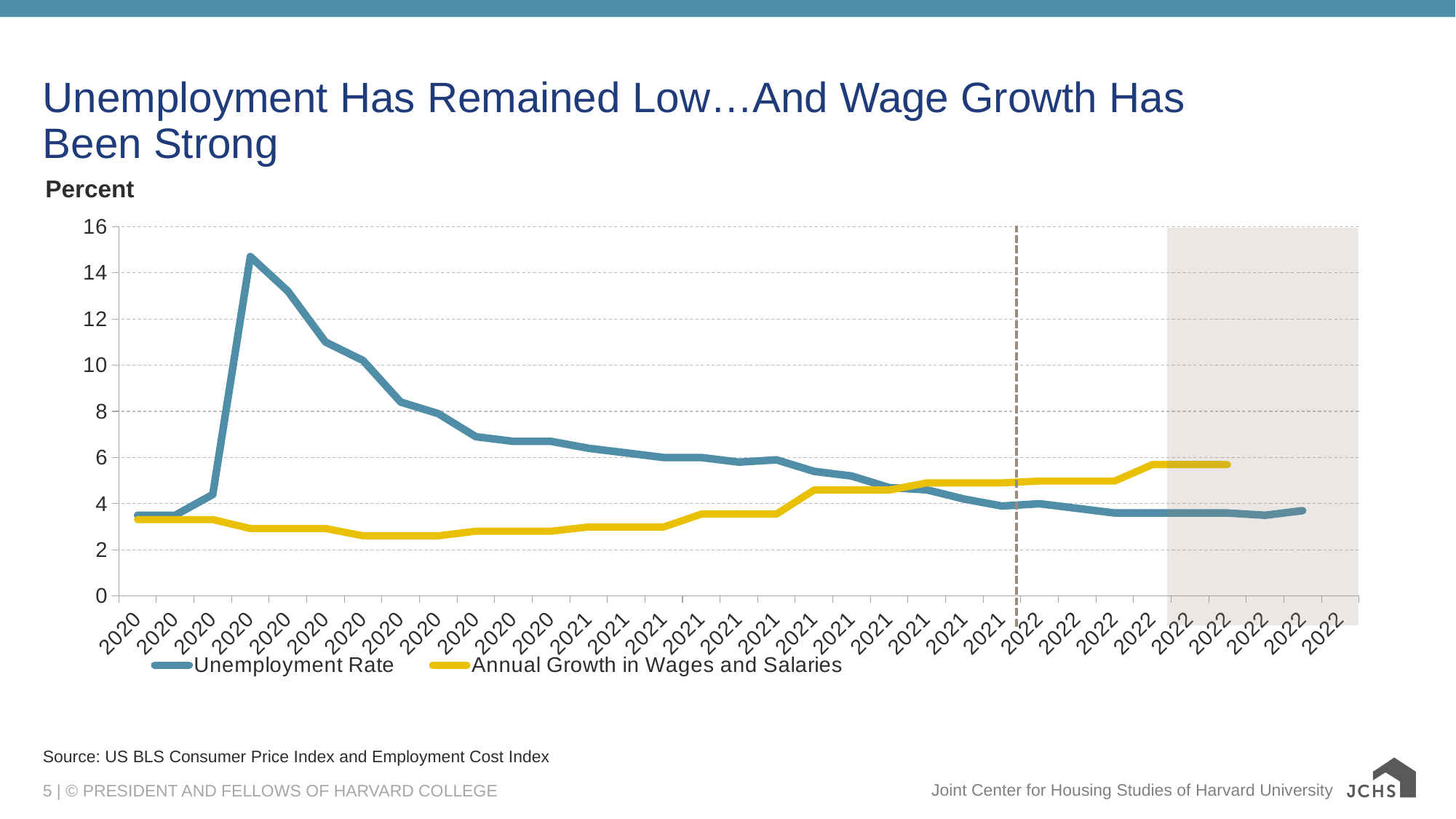
At the peak of the Unemployment Rate in 2020, which series is higher: Unemployment Rate or Annual Growth in Wages and Salaries? Unemployment Rate How many series does the legend list? 2 Is the lowest value of the Annual Growth in Wages and Salaries line greater or less than 3? less At the end of the chart in 2022, which series is higher: Unemployment Rate or Annual Growth in Wages and Salaries? Annual Growth in Wages and Salaries What kind of chart is shown on the slide? Line chart After its 2020 peak, does the Unemployment Rate line rise or fall through 2021 and 2022? fall Does the Annual Growth in Wages and Salaries line rise or fall from 2021 into 2022? rise Is the peak value of the Unemployment Rate line greater or less than 14? greater Is the final value of the Unemployment Rate line greater or less than 4? less What unit is shown on the vertical axis label? Percent What are the two series named in the legend? Unemployment Rate; Annual Growth in Wages and Salaries